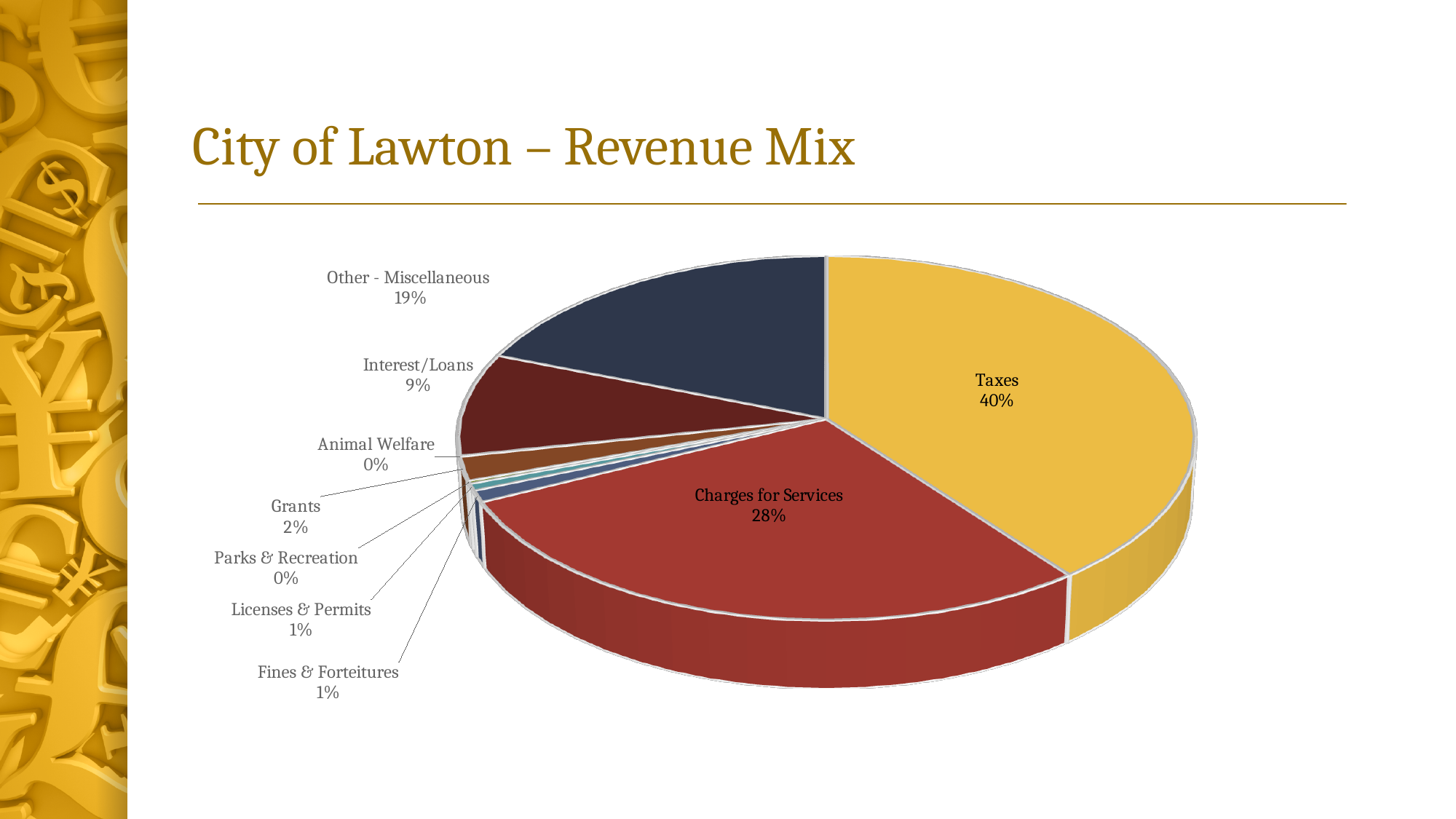
What kind of chart is shown on the slide? Pie chart What share does Other - Miscellaneous represent? 19% How many revenue categories are shown in the pie chart? 9 Which two categories are labelled with 0%? Animal Welfare and Parks & Recreation Which is larger, Other - Miscellaneous or Interest/Loans? Other - Miscellaneous What percentage of the revenue mix is Charges for Services? 28% What percentage is shown for Grants? 2% What share of revenue comes from Taxes? 40% Which revenue category has the largest share? Taxes What is the title of the slide containing the chart? City of Lawton – Revenue Mix What percentage is shown for Interest/Loans? 9% What is the difference in percentage points between Taxes and Charges for Services? 12